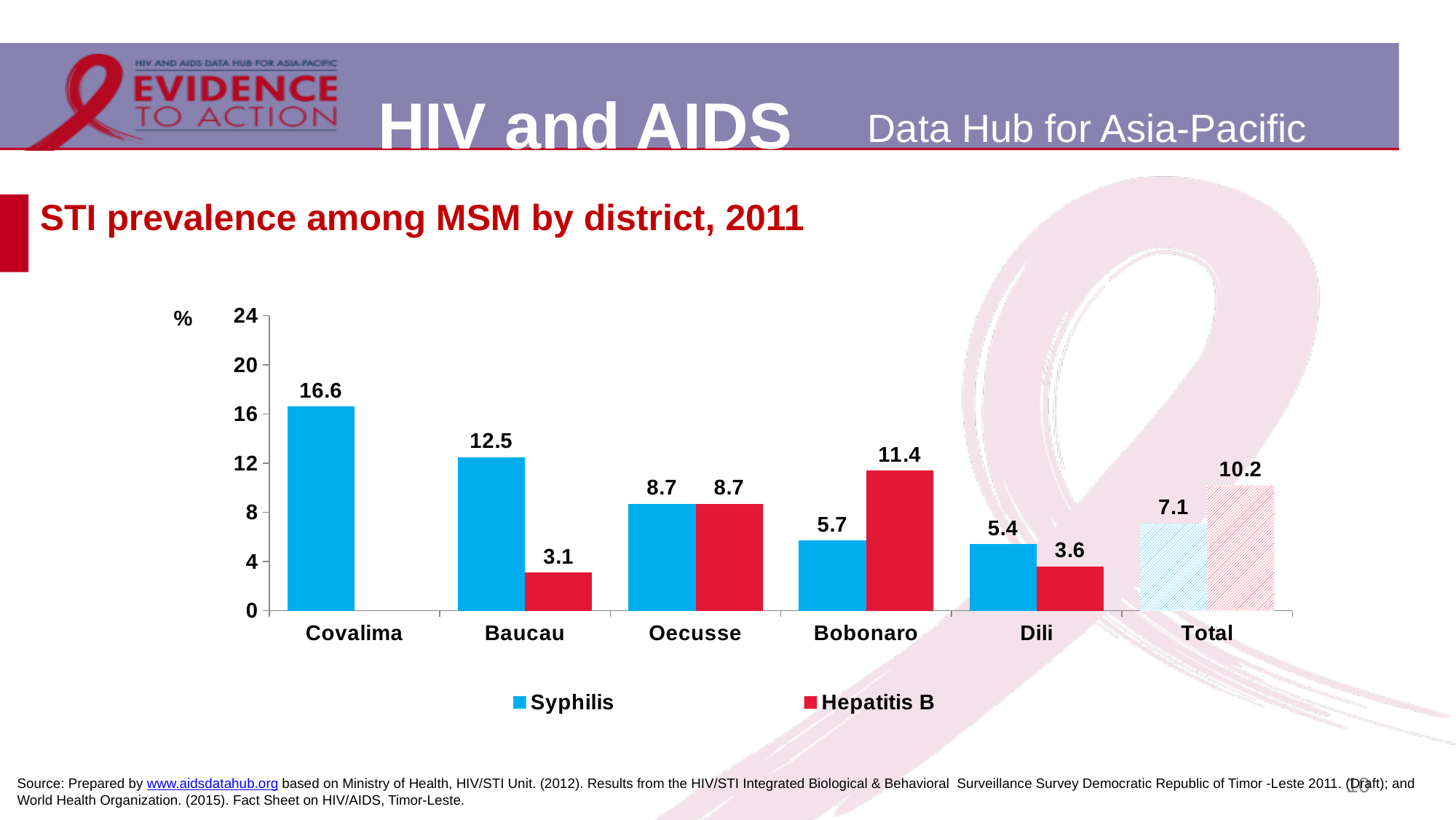
What is the Syphilis prevalence for Covalima? 16.6 How many categories are shown on the x axis? 6 How many series does the legend list? 2 What is the Hepatitis B prevalence for Bobonaro? 11.4 What kind of chart is shown on the slide? bar chart Which district has the lowest Hepatitis B prevalence among those with a Hepatitis B bar? Baucau What is the difference between the Syphilis and Hepatitis B values for Baucau? 9.4 Which is larger for Bobonaro, Syphilis or Hepatitis B? Hepatitis B What is the title of the chart? STI prevalence among MSM by district, 2011 What is the Hepatitis B value for Total? 10.2 Which district has the highest Syphilis prevalence? Covalima Is the Syphilis value for Dili greater or less than 8? less